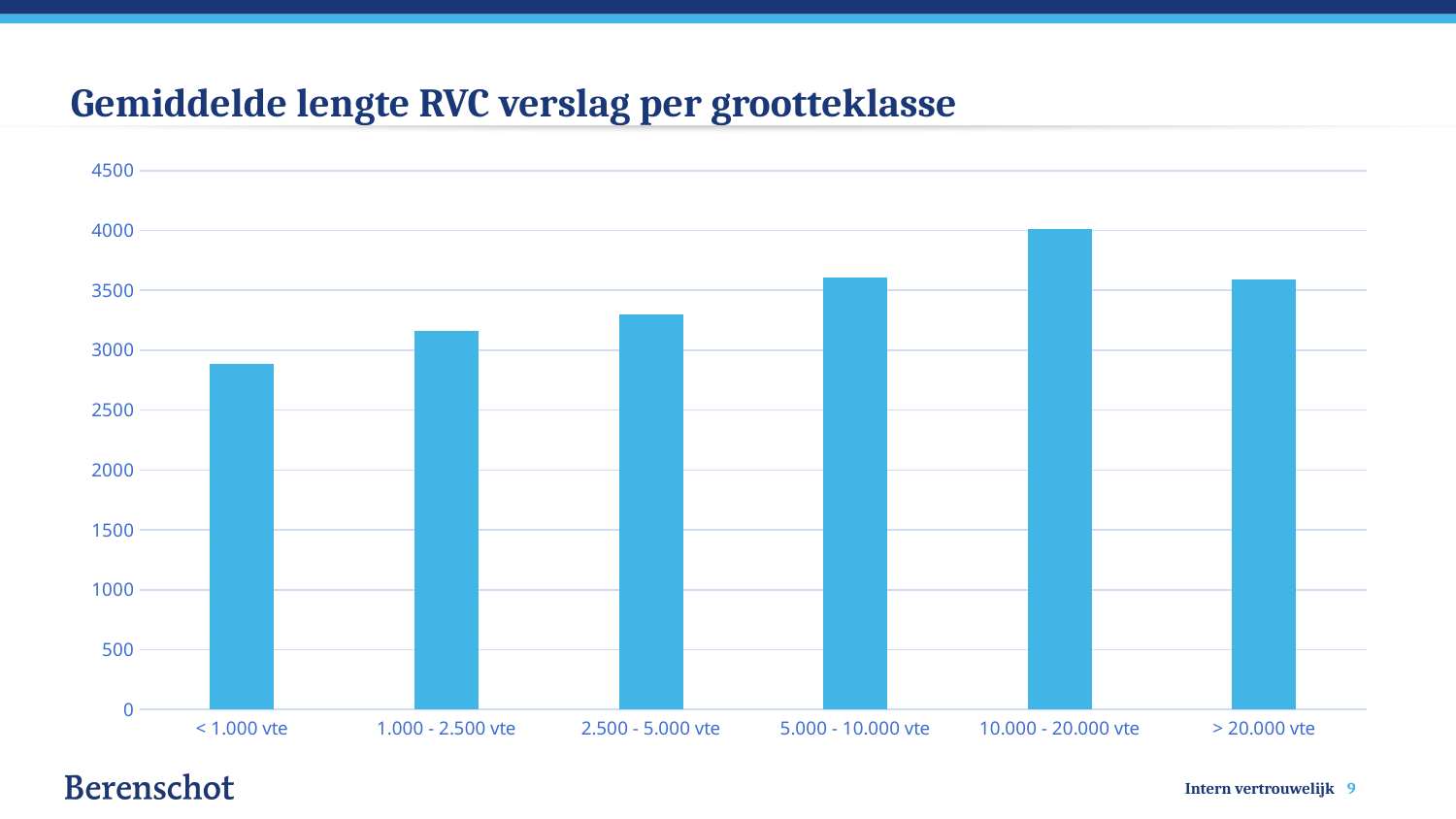
What is the title of the chart? Gemiddelde lengte RVC verslag per grootteklasse Which is larger, the value for < 1.000 vte or the value for 5.000 - 10.000 vte? 5.000 - 10.000 vte Is the value for 2.500 - 5.000 vte greater or less than 3000? greater What kind of chart is shown on the slide? bar chart How many size classes (categories) are shown on the x axis? 6 Is the value for 1.000 - 2.500 vte greater or less than 3500? less Which size class has the lowest average RVC report length? < 1.000 vte Is the value for < 1.000 vte greater or less than 3000? less Do the values rise or fall from < 1.000 vte through 10.000 - 20.000 vte? rise Which is larger, the value for 10.000 - 20.000 vte or the value for > 20.000 vte? 10.000 - 20.000 vte Which size class has the highest average RVC report length? 10.000 - 20.000 vte